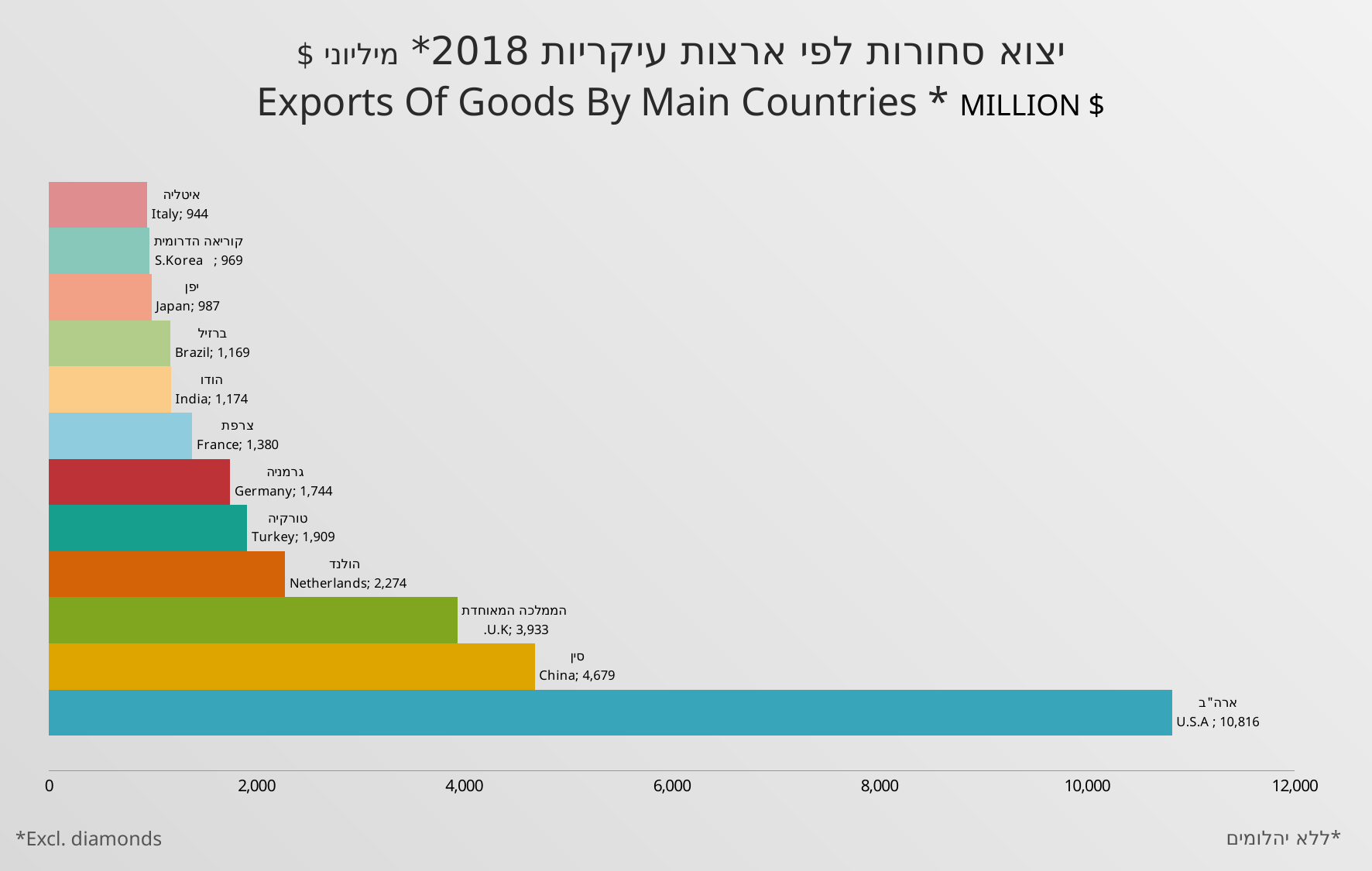
How many countries are shown in the chart? 12 What is the difference between the values for China and U.K? 746 Which country has the highest value? U.S.A What is the value for U.S.A? 10,816 Is the value for U.K greater or less than 4,000? less What is the value for Netherlands? 2,274 What kind of chart is shown on the slide? bar chart Which country has the lowest value? Italy What is the difference between the values for Turkey and France? 529 What is the value for Germany? 1,744 What is the English title of the chart? Exports Of Goods By Main Countries * MILLION $ Which is larger, the value for Brazil or the value for India? India